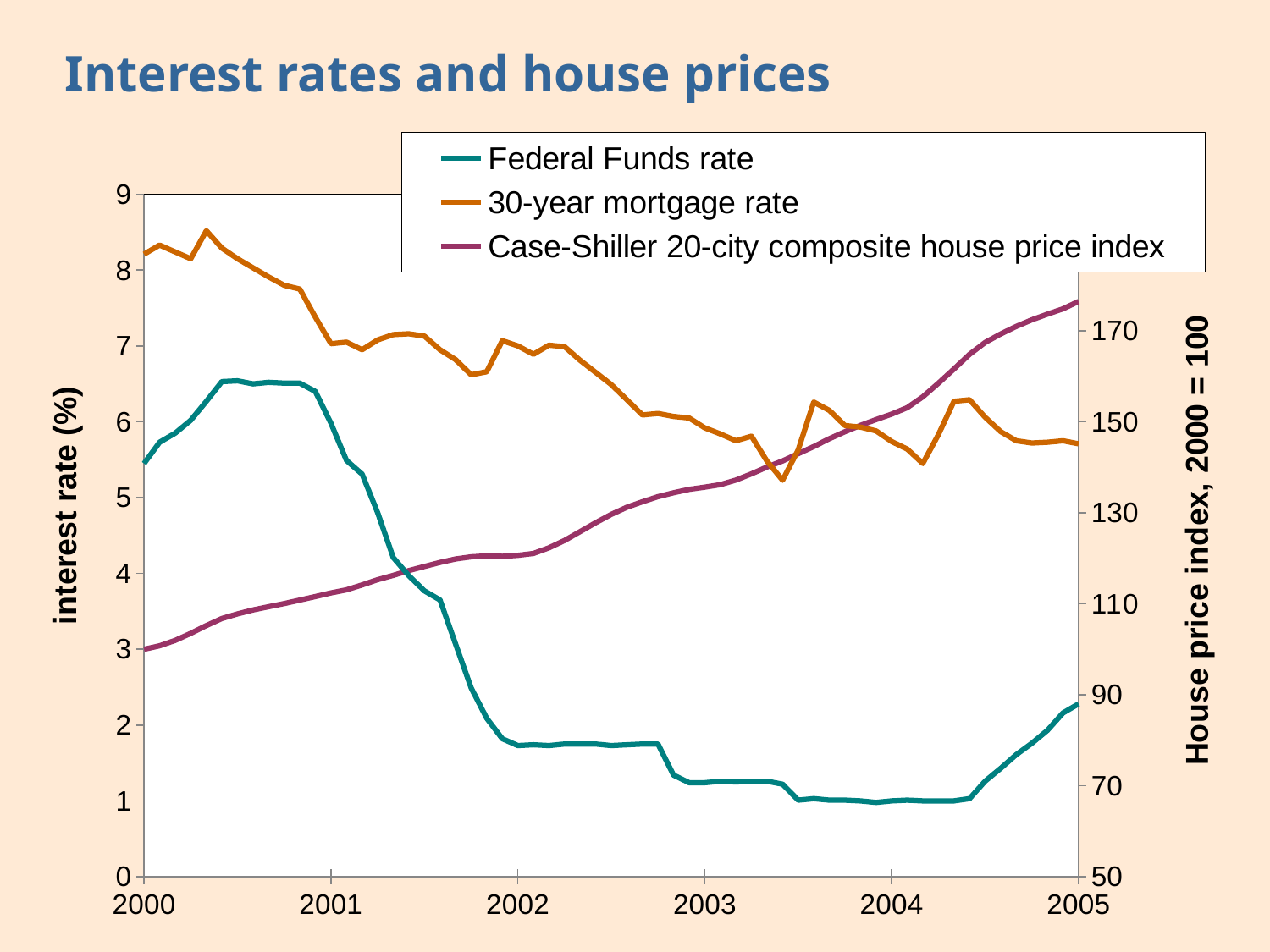
Is the Case-Shiller house price index at 2005 greater or less than 170? greater What is the title of the chart? Interest rates and house prices How many series does the legend list? 3 What kind of chart is shown on the slide? line chart Does the Federal Funds rate rise or fall between 2001 and 2003? fall At 2002, which is higher: the Federal Funds rate or the 30-year mortgage rate? 30-year mortgage rate Is the Federal Funds rate at 2005 greater or less than 3? less Is the 30-year mortgage rate at the start of 2000 greater or less than 8? greater What is the label of the right-hand vertical axis? House price index, 2000 = 100 Does the 30-year mortgage rate rise or fall overall from 2000 to 2005? fall Does the Case-Shiller 20-city composite house price index rise or fall from 2000 to 2005? rise